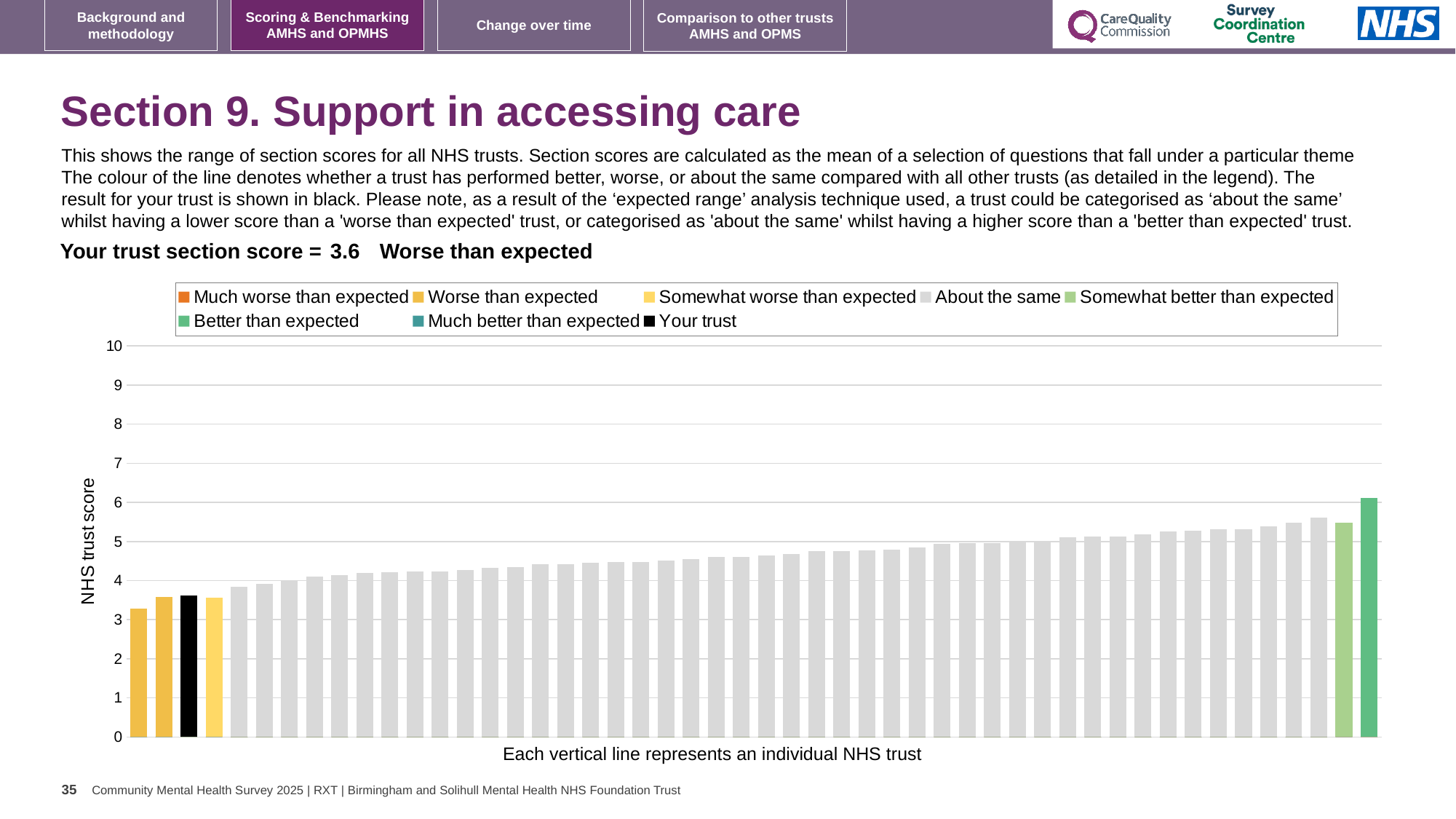
Is the value of the tallest bar greater or less than 5? greater Is the value of the shortest bar greater or less than 4? less Which performance category is your trust placed in for this section? Worse than expected Is the value of the tallest bar greater or less than 7? less Which is larger: the black bar for your trust or the dark green bar at the far right? the dark green bar at the far right What is the label on the vertical axis of the chart? NHS trust score What does the caption below the chart say each vertical line represents? an individual NHS trust Do the bar values rise or fall from left to right along the x axis? rise How many entries does the chart legend list? 8 What kind of chart is shown on the slide? bar chart What is the section score for your trust shown on the slide? 3.6